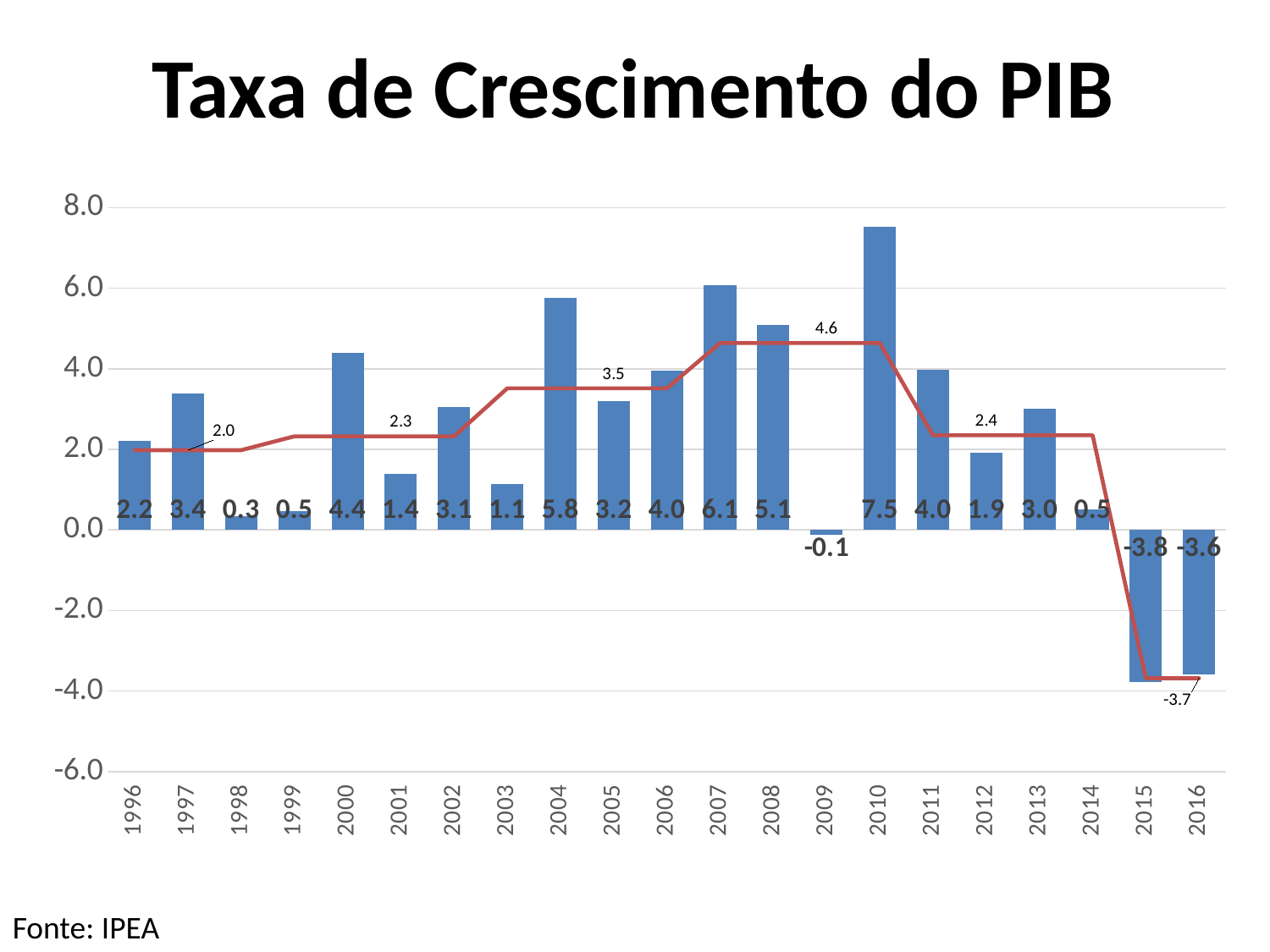
Do the bar values rise or fall from 2013 to 2016? Fall What is the title of the chart? Taxa de Crescimento do PIB What value does the red line show for the period covering 2007 to 2010? 4.6 What is the GDP growth rate shown for 2010? 7.5 Which is larger, the value for 2004 or the value for 2000? 2004 What is the value shown for 2015? -3.8 What is the difference between the values for 2007 and 2008? 1.0 What kind of chart is this? Bar chart with a line overlay How many years are shown on the x axis? 21 Which year has the highest bar? 2010 What is the value shown for 2009? -0.1 Which year has the lowest bar? 2015